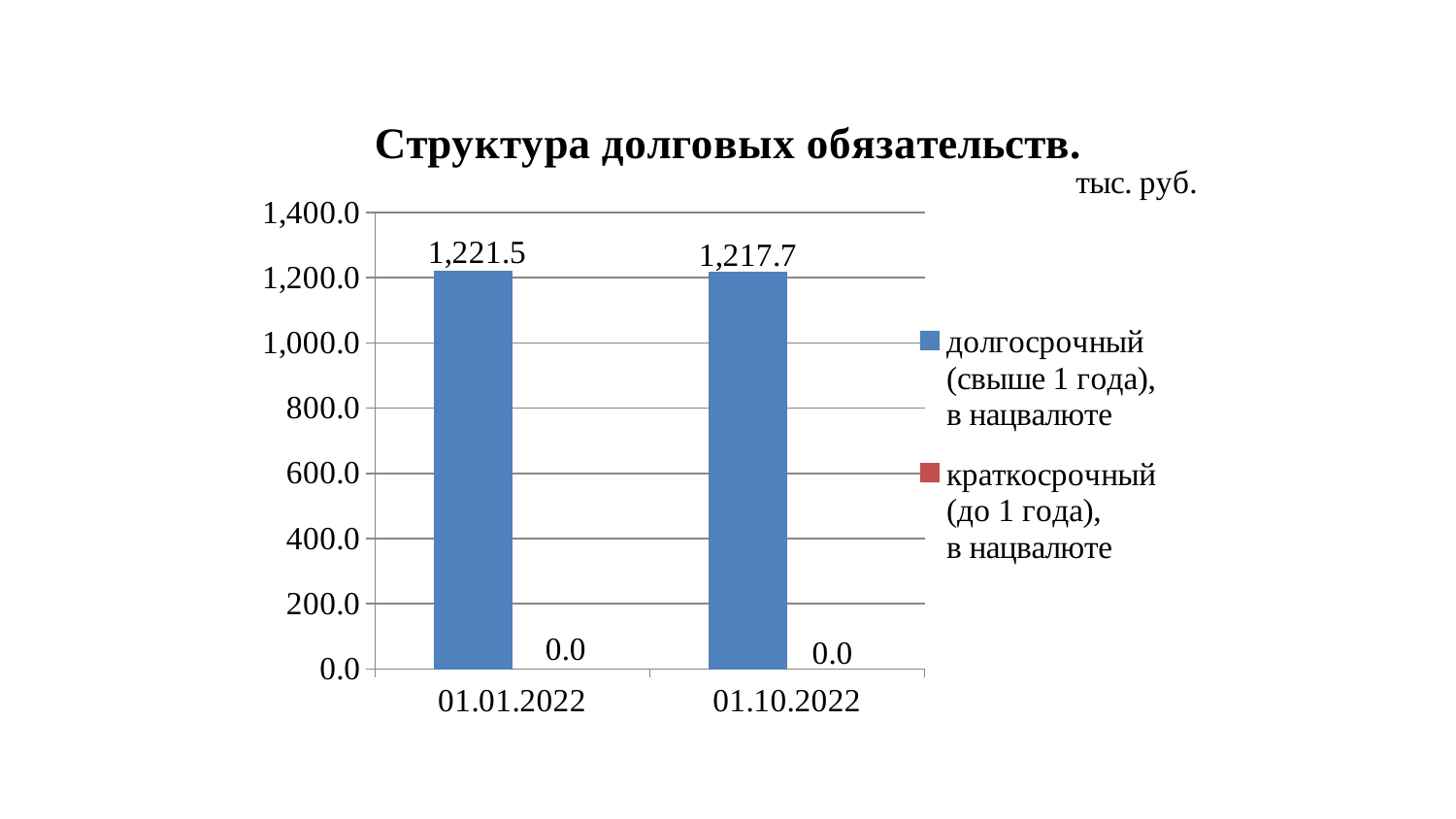
How many dates are shown on the x axis? 2 What is the title of the chart? Структура долговых обязательств. Does the долгосрочный (свыше 1 года) value rise or fall from 01.01.2022 to 01.10.2022? fall Which date has the higher долгосрочный (свыше 1 года) value, 01.01.2022 or 01.10.2022? 01.01.2022 Is the долгосрочный value on 01.10.2022 greater or less than 1,000.0? greater What kind of chart is shown on the slide? bar chart How many series does the legend list? 2 What is the value for краткосрочный (до 1 года), в нацвалюте on 01.01.2022? 0.0 What is the value for долгосрочный (свыше 1 года), в нацвалюте on 01.10.2022? 1,217.7 What is the value for краткосрочный (до 1 года), в нацвалюте on 01.10.2022? 0.0 What is the difference between the долгосрочный values on 01.01.2022 and 01.10.2022? 3.8 What is the value for долгосрочный (свыше 1 года), в нацвалюте on 01.01.2022? 1,221.5